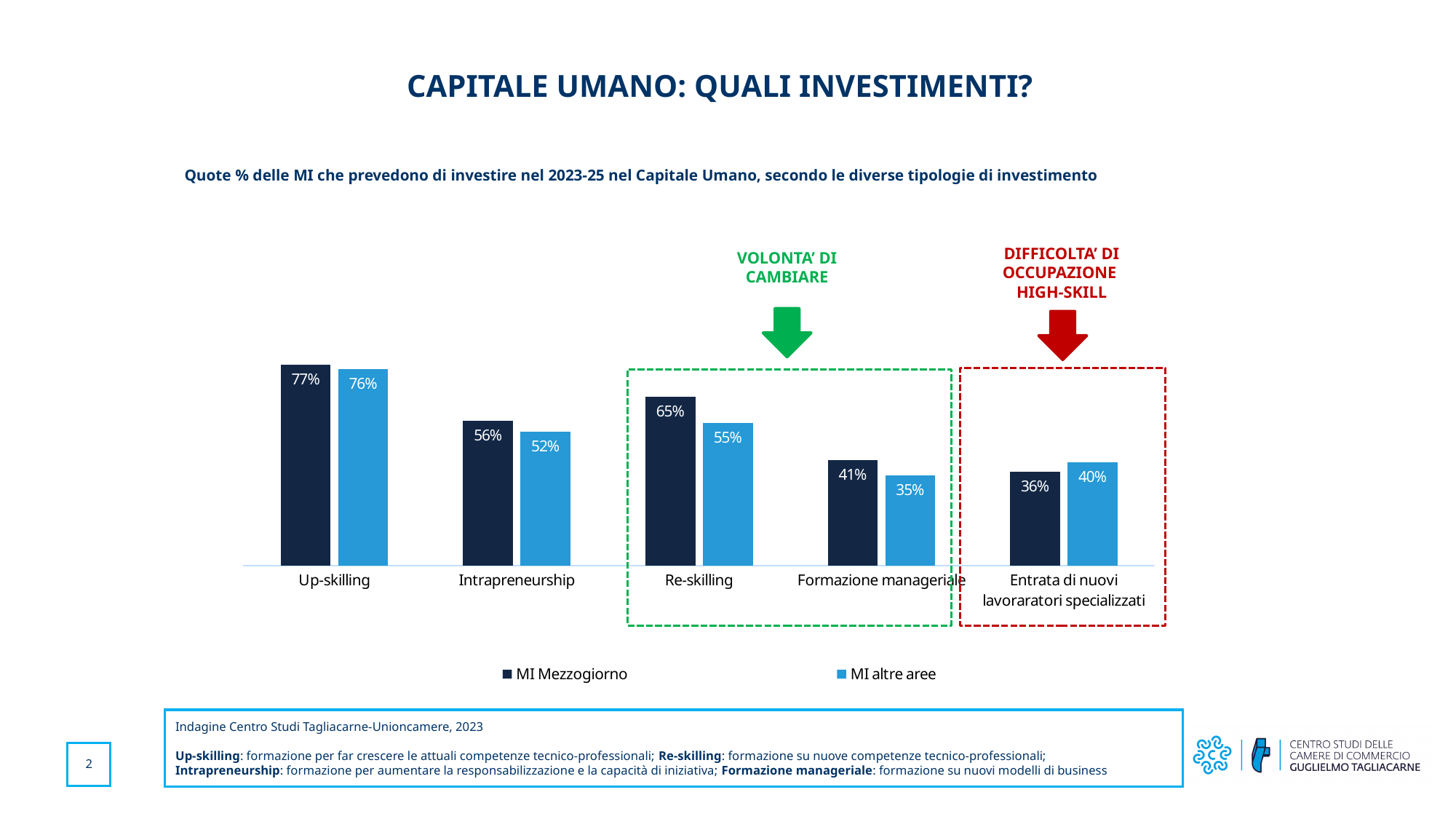
How many series does the legend list? 2 How many categories are shown on the x axis? 5 Which category has the lowest value for MI altre aree? Formazione manageriale Which category has the highest value for MI Mezzogiorno? Up-skilling In the Entrata di nuovi lavoraratori specializzati category, which series has the larger value? MI altre aree Which category is enclosed in the red dashed box labelled 'DIFFICOLTA' DI OCCUPAZIONE HIGH-SKILL'? Entrata di nuovi lavoraratori specializzati What is the value for MI altre aree in the Formazione manageriale category? 35% What is the value for MI Mezzogiorno in the Up-skilling category? 77% What kind of chart is shown on the slide? Bar chart What is the difference between MI Mezzogiorno and MI altre aree in the Re-skilling category? 10 percentage points What is the value for MI altre aree in the Entrata di nuovi lavoraratori specializzati category? 40%